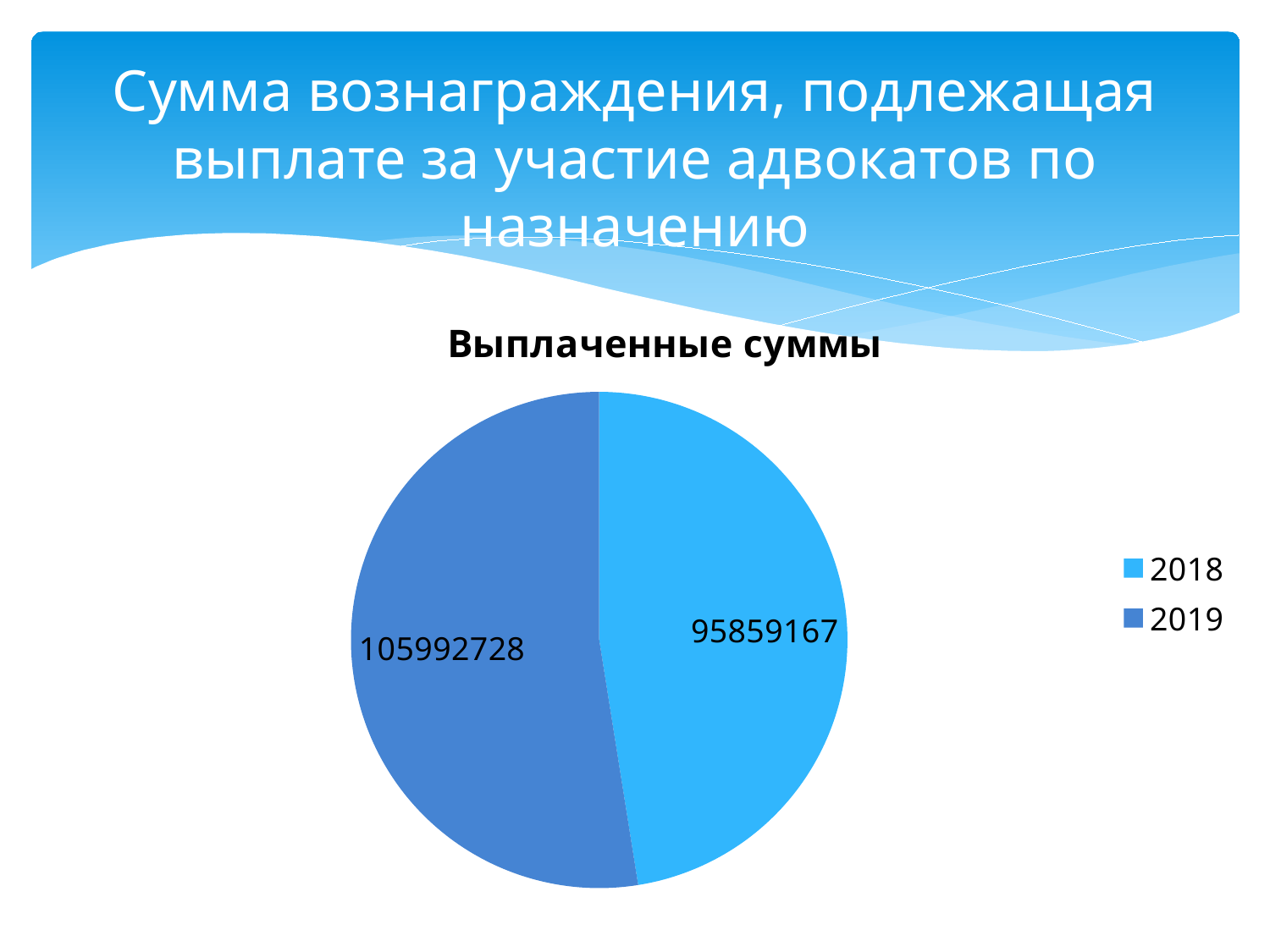
How many slices does the pie chart have? 2 What is the value for 2018? 95859167 Is the value for 2019 larger or smaller than the value for 2018? larger What is the title of the chart? Выплаченные суммы What is the total of the two values shown in the pie chart? 201851895 What type of chart is shown on the slide? pie chart Which year has the larger value? 2019 How many series does the legend list? 2 Which year has the smaller value? 2018 What is the difference between the values for 2019 and 2018? 10133561 Which legend entry is shown in the lighter blue colour? 2018 What is the value for 2019? 105992728